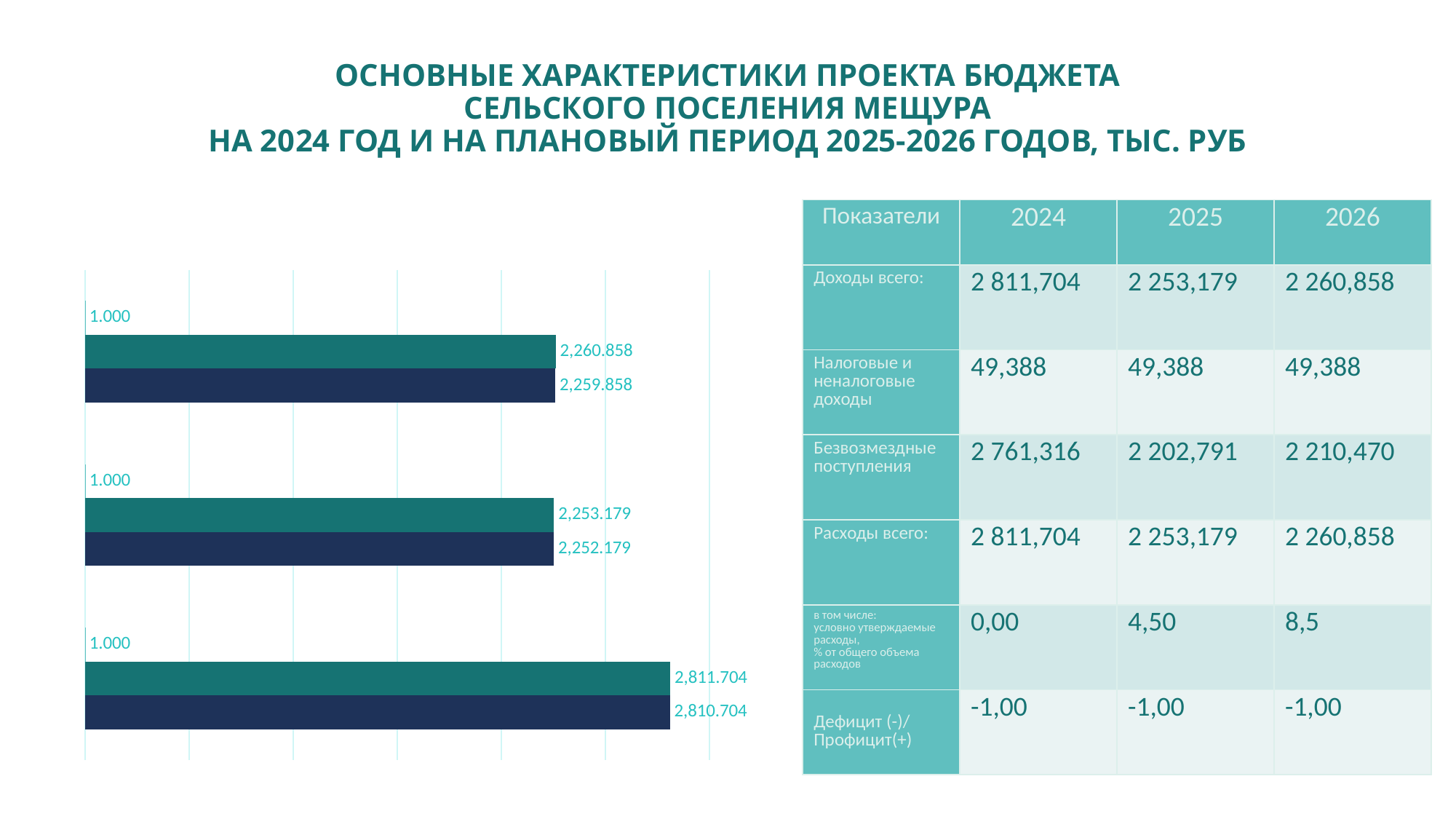
In the chart on the left, what is the value labelled on the dark navy bar in the middle group? 2,252.179 In the chart on the left, what is the difference between the teal bar and the dark navy bar in the bottom group? 1.000 How many groups of bars does the chart on the left contain? 3 In the chart on the left, is the teal bar in the top group or the teal bar in the middle group larger? top group In the chart on the left, which group of bars (top, middle or bottom) has the longest bars? bottom In the chart on the left, what is the difference between the teal bar in the top group and the teal bar in the middle group? 7.679 In the chart on the left, which group of bars (top, middle or bottom) has the shortest teal bar? middle In the chart on the left, what is the value labelled on the teal bar in the top group? 2,260.858 In the chart on the left, what is the value labelled on the dark navy bar in the bottom group? 2,810.704 What type of chart is shown on the left of the slide? bar chart In the chart on the left, what value label appears above the teal bar in each group? 1.000 In the chart on the left, what is the value labelled on the teal bar in the bottom group? 2,811.704